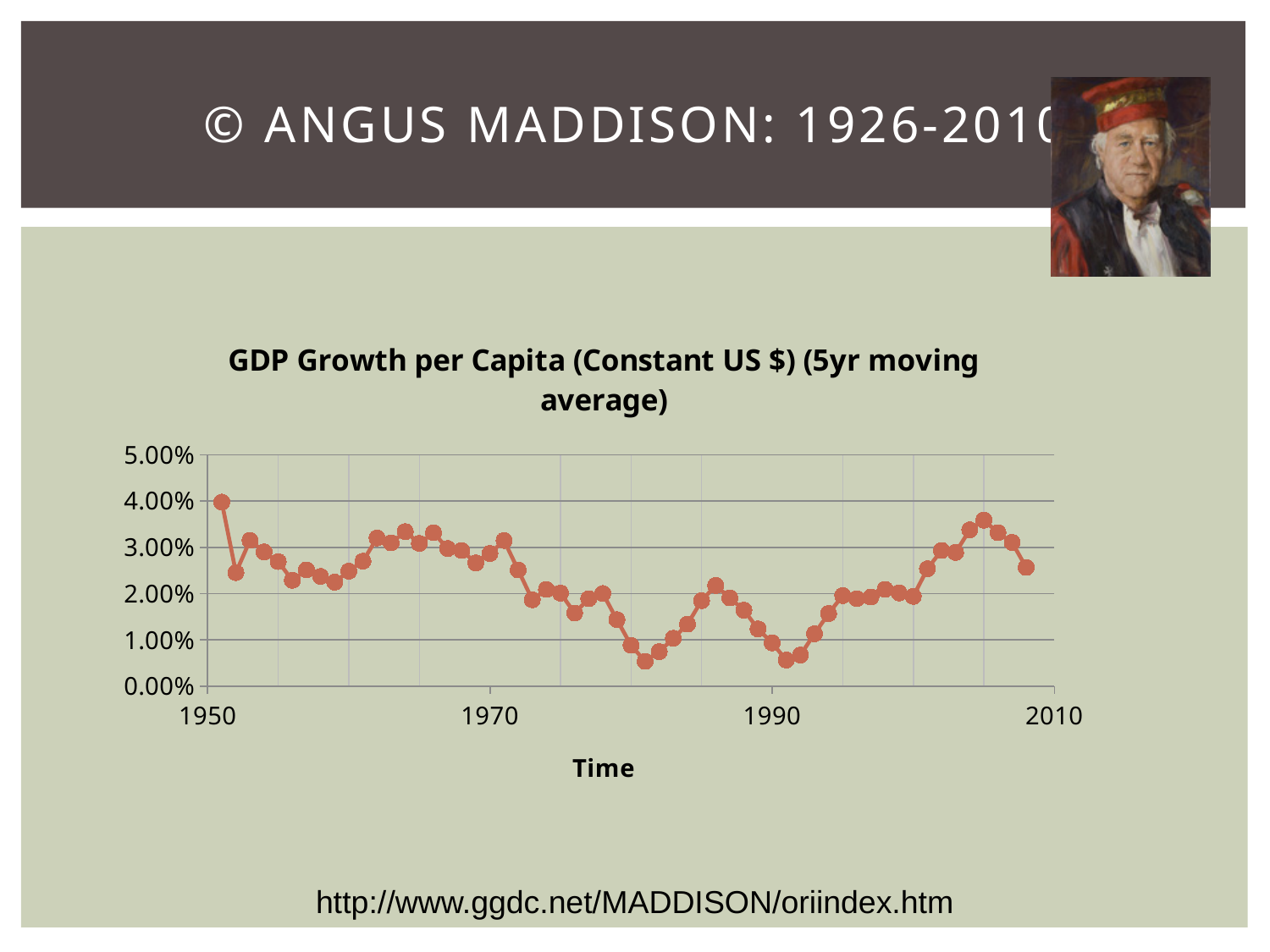
What is the highest value shown on the y axis? 5.00% Is the value of the peak around 2005 greater or less than 3.00%? greater What is the label on the x axis of the chart? Time Which is larger: the value of the first plotted point (around 1951) or the value of the peak around 2005? the first plotted point (around 1951) Do the values generally rise or fall between 1991 and 2005? rise Is the value of the lowest point around 1981 greater or less than 1.00%? less What is the title of the chart? GDP Growth per Capita (Constant US $) (5yr moving average) What kind of chart is shown on the slide? line chart Is the value of the first plotted point (around 1951) greater or less than 3.00%? greater Do the values generally rise or fall between 1971 and 1981? fall